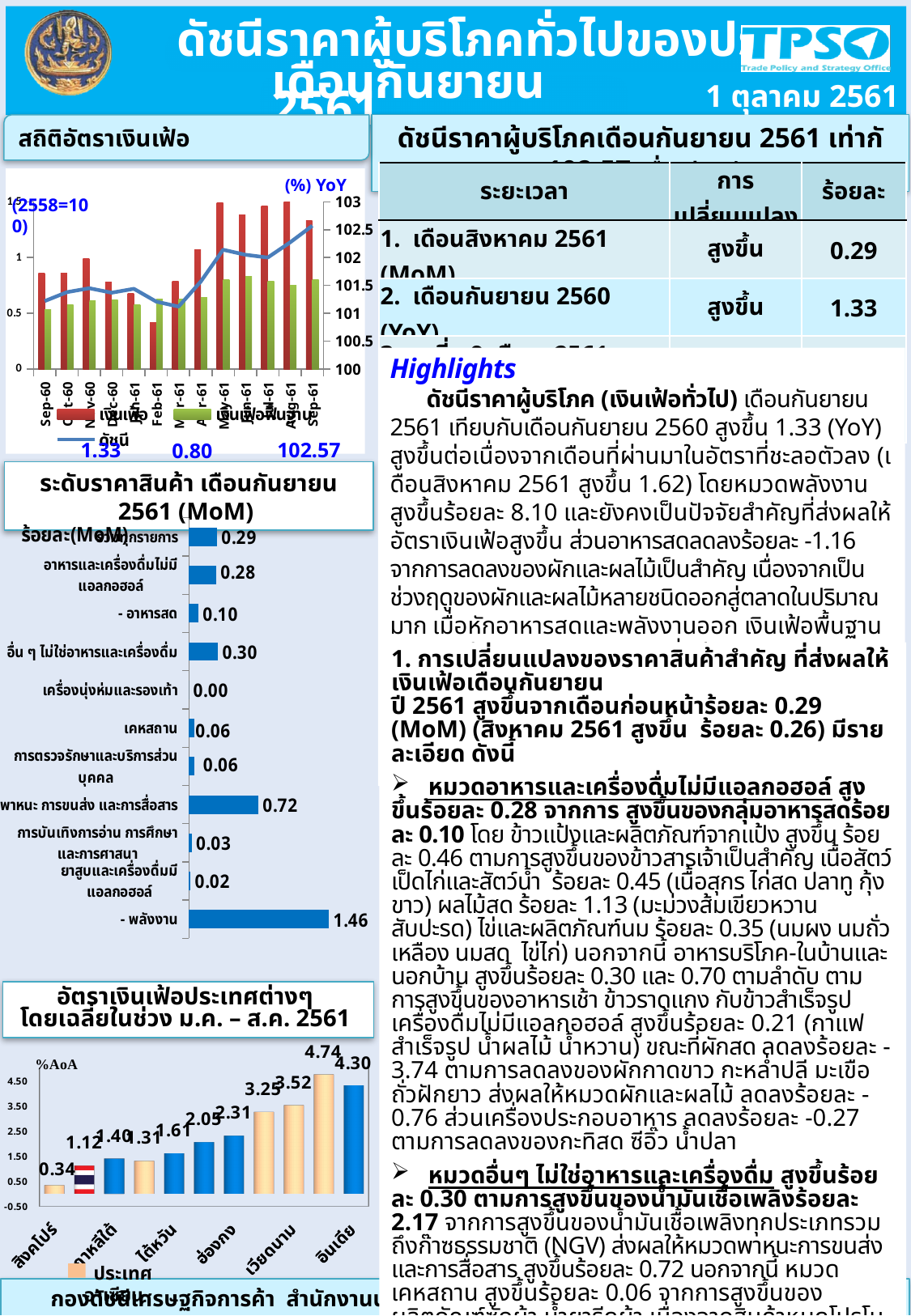
In the ระดับราคาสินค้า เดือนกันยายน 2561 (MoM) chart, what is the value for พาหนะ การขนส่ง และการสื่อสาร? 0.72 In the ระดับราคาสินค้า เดือนกันยายน 2561 (MoM) chart, what is the value for - พลังงาน? 1.46 In the ระดับราคาสินค้า เดือนกันยายน 2561 (MoM) chart, what is the difference between the values for - พลังงาน and พาหนะ การขนส่ง และการสื่อสาร? 0.74 In the สถิติอัตราเงินเฟ้อ chart, what is the value of ดัชนี for Sep-61? 102.57 In the ระดับราคาสินค้า เดือนกันยายน 2561 (MoM) chart, which category has the lowest value? เครื่องนุ่งห่มและรองเท้า In the ระดับราคาสินค้า เดือนกันยายน 2561 (MoM) chart, which is larger: the value for - อาหารสด or the value for เคหสถาน? - อาหารสด How many series does the legend of the สถิติอัตราเงินเฟ้อ chart list? 3 In the ระดับราคาสินค้า เดือนกันยายน 2561 (MoM) chart, which category has the highest value? - พลังงาน How many bars are shown in the อัตราเงินเฟ้อประเทศต่างๆ chart? 11 What kind of chart is the ระดับราคาสินค้า เดือนกันยายน 2561 (MoM) chart? Bar chart How many categories are shown in the ระดับราคาสินค้า เดือนกันยายน 2561 (MoM) chart? 11 In the อัตราเงินเฟ้อประเทศต่างๆ chart, what is the largest value labelled on any bar? 4.74